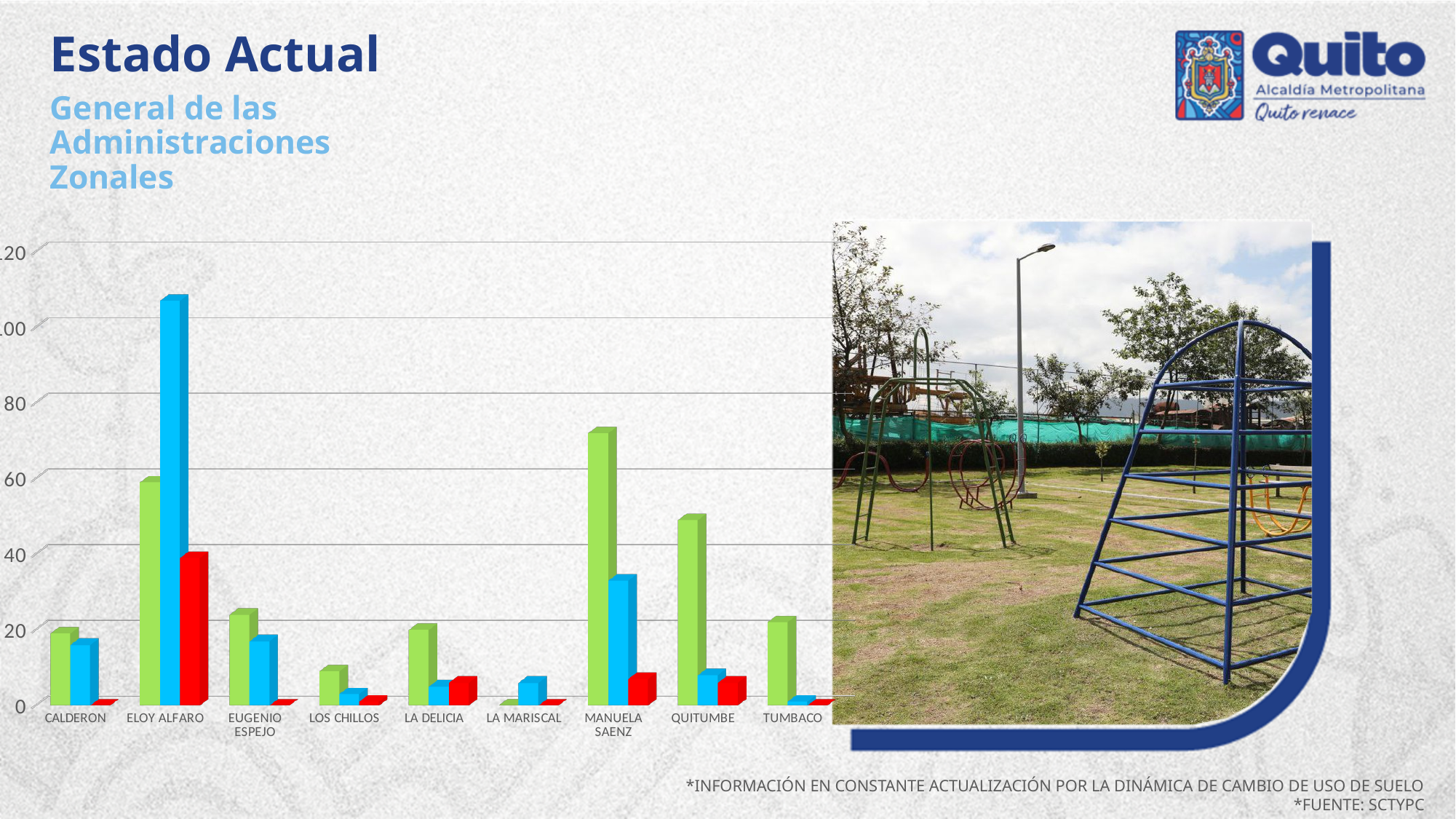
Which category has the smallest green bar in the chart? LA MARISCAL How many differently coloured bars are shown for each category in the chart? 3 Is the value of the green bar for MANUELA SAENZ greater or less than 60? greater Which has the larger green bar, MANUELA SAENZ or ELOY ALFARO? MANUELA SAENZ How many categories (administraciones zonales) are shown on the x axis of the chart? 9 Which category has the tallest bar in the chart? ELOY ALFARO What is the highest tick value shown on the vertical axis of the chart? 120 Is the value of the green bar for CALDERON greater or less than 40? less Is the value of the red bar for ELOY ALFARO greater or less than 20? greater Which has the larger green bar, QUITUMBE or TUMBACO? QUITUMBE What kind of chart is shown on the slide? bar chart